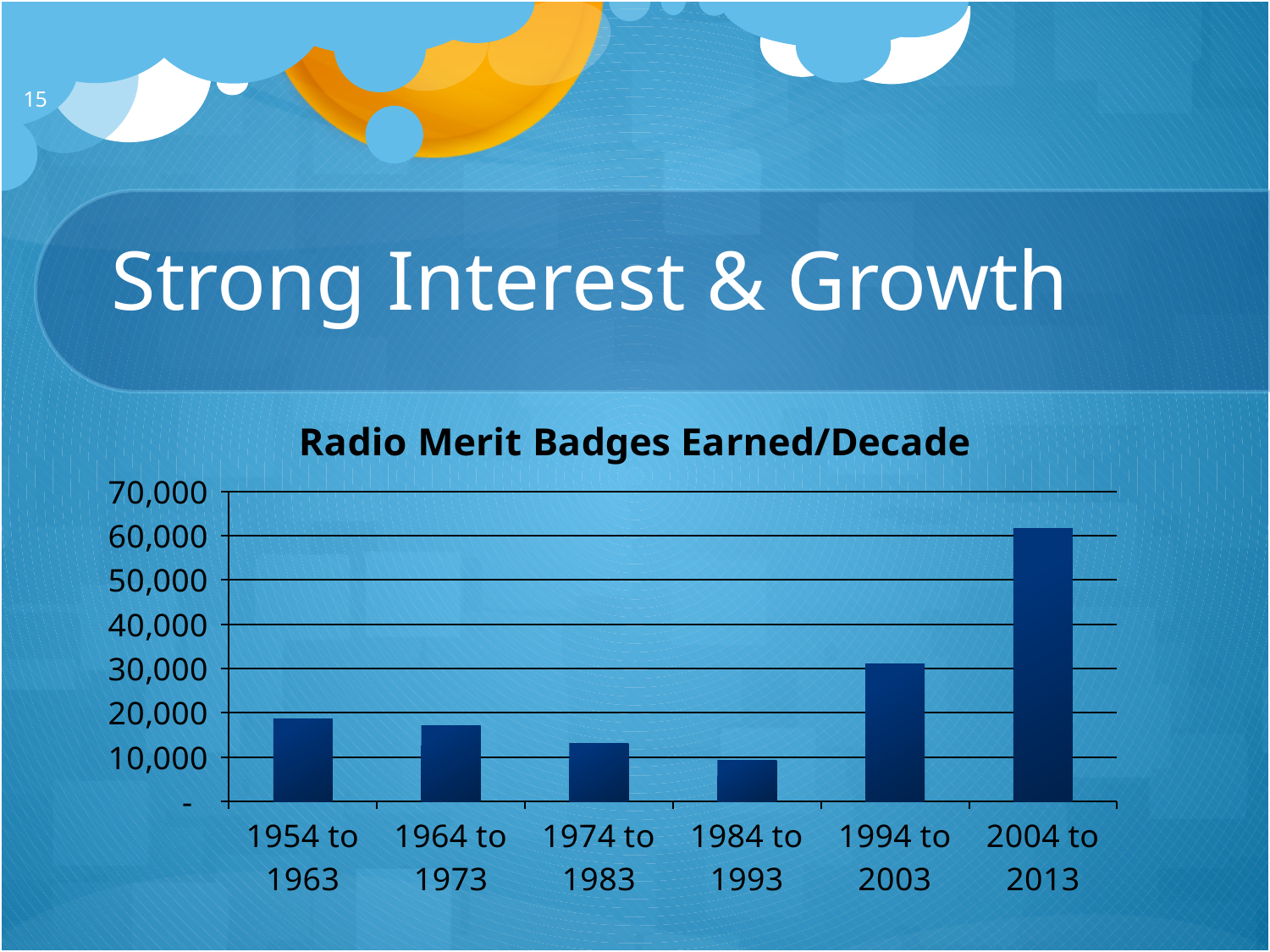
Is the value for 2004 to 2013 greater or less than 60,000? greater Which decade has the lowest number of radio merit badges earned? 1984 to 1993 Do the values rise or fall from 1954 to 1963 through 1984 to 1993? fall Is the value for 1984 to 1993 greater or less than 10,000? less What is the title of the chart? Radio Merit Badges Earned/Decade Which is larger, the value for 1994 to 2003 or the value for 1954 to 1963? 1994 to 2003 Which decade has the highest number of radio merit badges earned? 2004 to 2013 Is the value for 1974 to 1983 greater or less than 10,000? greater How many decade categories are shown on the x axis of the chart? 6 What type of chart is shown on the slide? bar chart